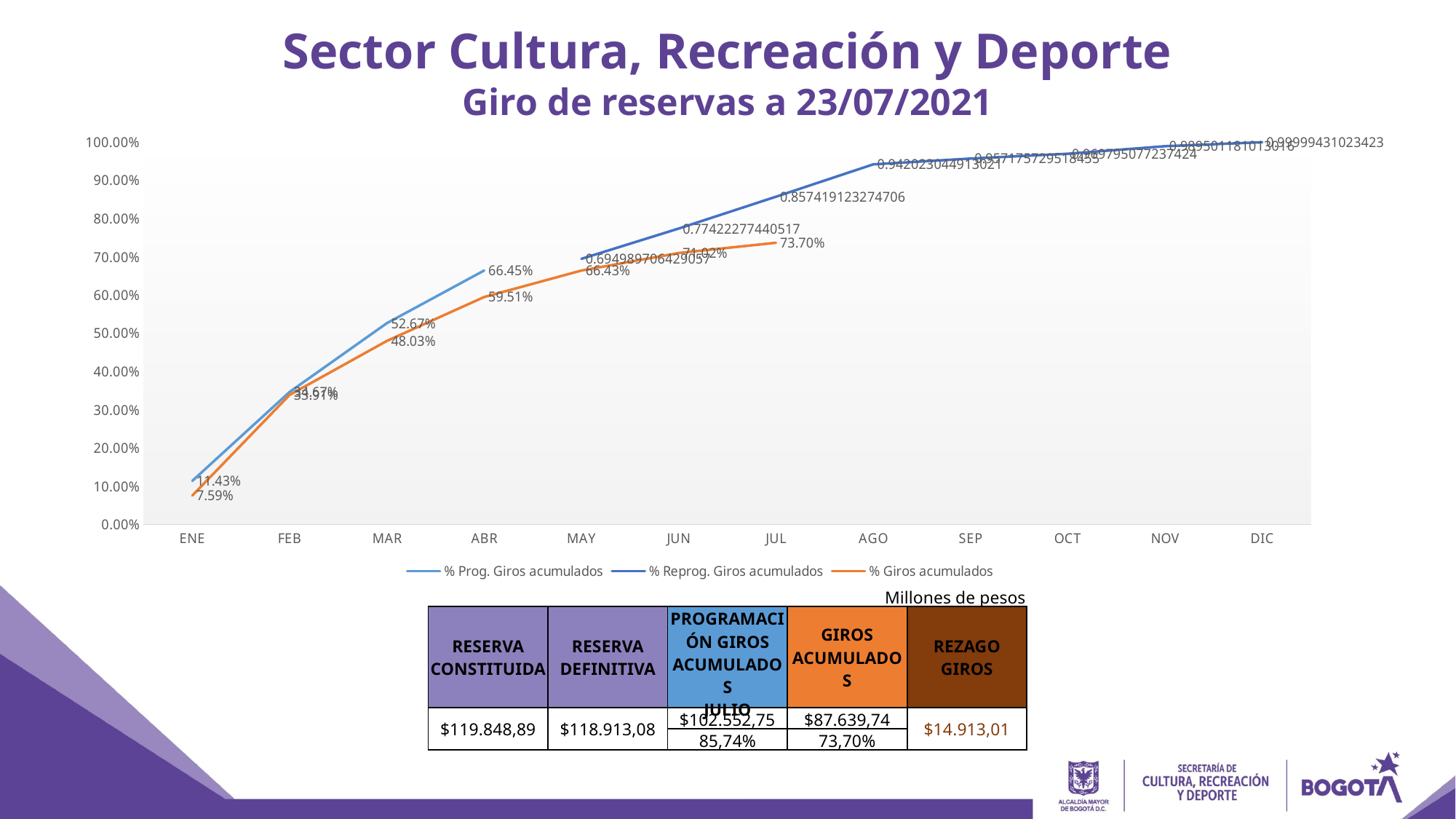
What is the value of % Prog. Giros acumulados in ABR? 66.45% What is the value of % Giros acumulados in JUL? 73.70% What is the value of % Giros acumulados in ENE? 7.59% Does the % Giros acumulados line rise or fall from ENE to JUL? Rises In ABR, which is higher: % Prog. Giros acumulados or % Giros acumulados? % Prog. Giros acumulados What is the difference between % Prog. Giros acumulados and % Giros acumulados in MAR? 4.64 percentage points In which month does % Giros acumulados reach its highest value? JUL Is the value of % Reprog. Giros acumulados in AGO greater or less than 90.00%? greater How many series does the chart legend list? 3 How many months are shown along the x axis of the chart? 12 What kind of chart is shown on the slide? Line chart What is the value of % Prog. Giros acumulados in ENE? 11.43%